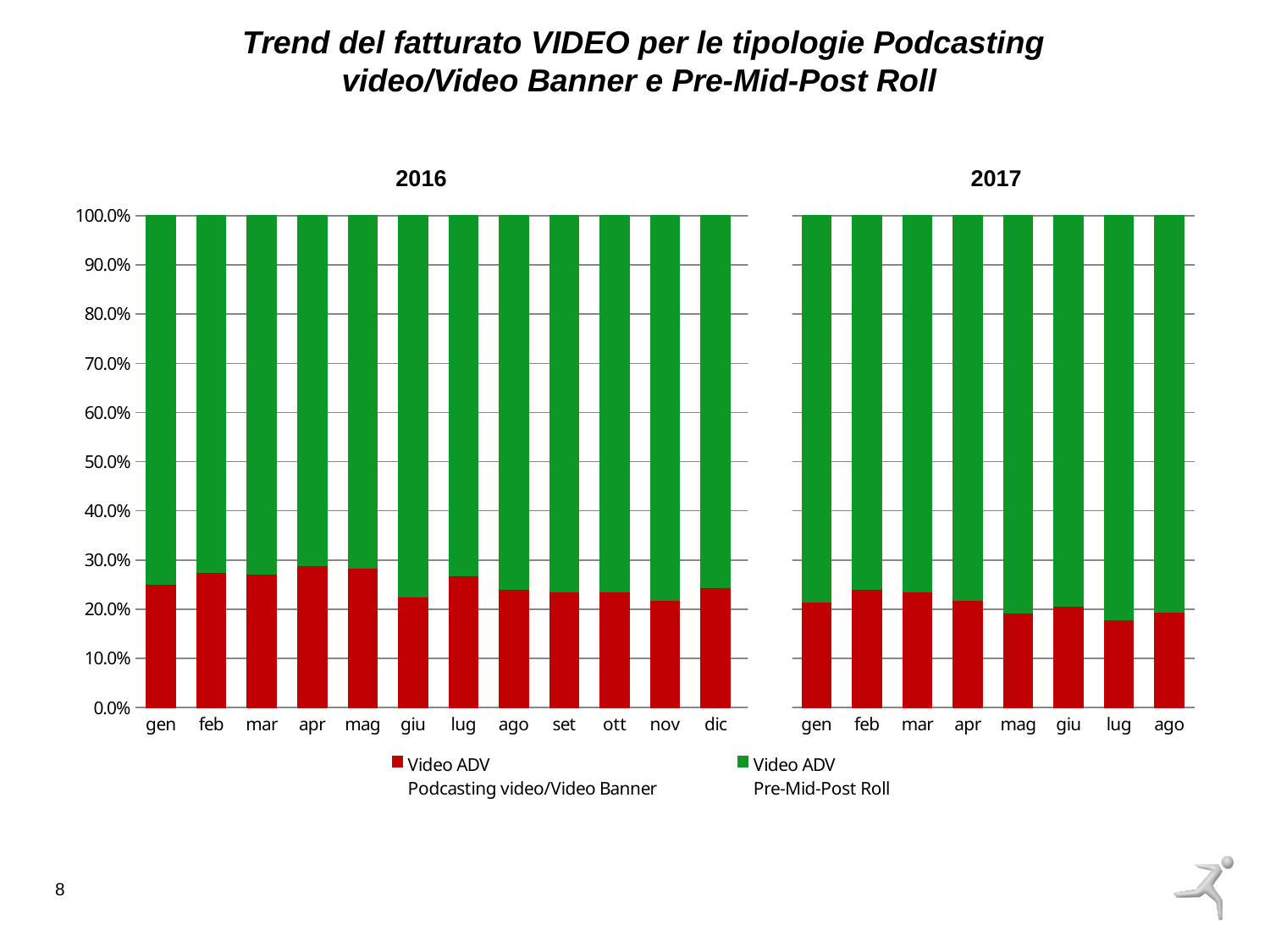
In the 2017 chart, which month has the lowest share for Video ADV Podcasting video/Video Banner? lug In the 2016 chart, is the share for Video ADV Podcasting video/Video Banner in gen greater or less than 20.0%? greater In the 2017 chart, does the share for Video ADV Podcasting video/Video Banner generally rise or fall from gen to ago? fall In the 2016 chart, which month has the larger share for Video ADV Podcasting video/Video Banner, apr or giu? apr In the 2017 chart, is the share for Video ADV Podcasting video/Video Banner in lug greater or less than 20.0%? less How many series does the legend list? 2 In the 2017 chart, which month has the larger share for Video ADV Podcasting video/Video Banner, feb or lug? feb In the 2016 chart, how many months are plotted along the x axis? 12 What kind of chart is shown on the slide? Stacked bar chart Which series is shown in green in the charts? Video ADV Pre-Mid-Post Roll In the 2016 chart, is the share for Video ADV Podcasting video/Video Banner in apr greater or less than 30.0%? less In the 2017 chart, how many months are plotted along the x axis? 8